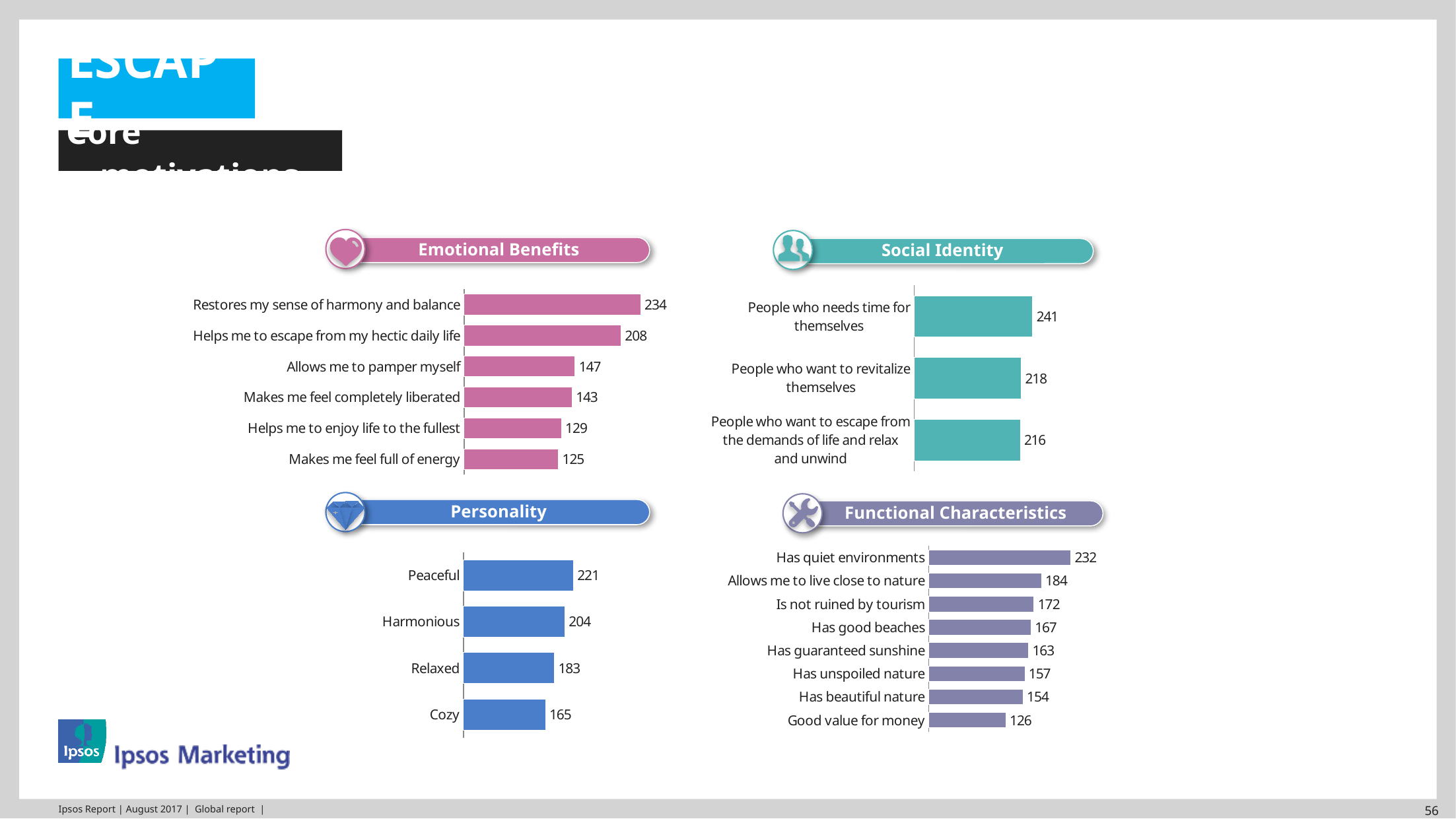
In the Emotional Benefits chart, what is the value for "Restores my sense of harmony and balance"? 234 In the Functional Characteristics chart, which category has the lowest value? Good value for money What kind of chart is the Personality chart? Bar chart In the Emotional Benefits chart, what is the difference between "Helps me to escape from my hectic daily life" and "Allows me to pamper myself"? 61 In the Personality chart, what is the value for "Relaxed"? 183 In the Social Identity chart, which category has the highest value? People who needs time for themselves In the Emotional Benefits chart, which category has the lowest value? Makes me feel full of energy How many categories does the Functional Characteristics chart show? 8 How many categories does the Social Identity chart show? 3 In the Functional Characteristics chart, what is the value for "Is not ruined by tourism"? 172 In the Social Identity chart, what is the value for "People who want to revitalize themselves"? 218 In the Personality chart, which is larger, "Harmonious" or "Cozy"? Harmonious